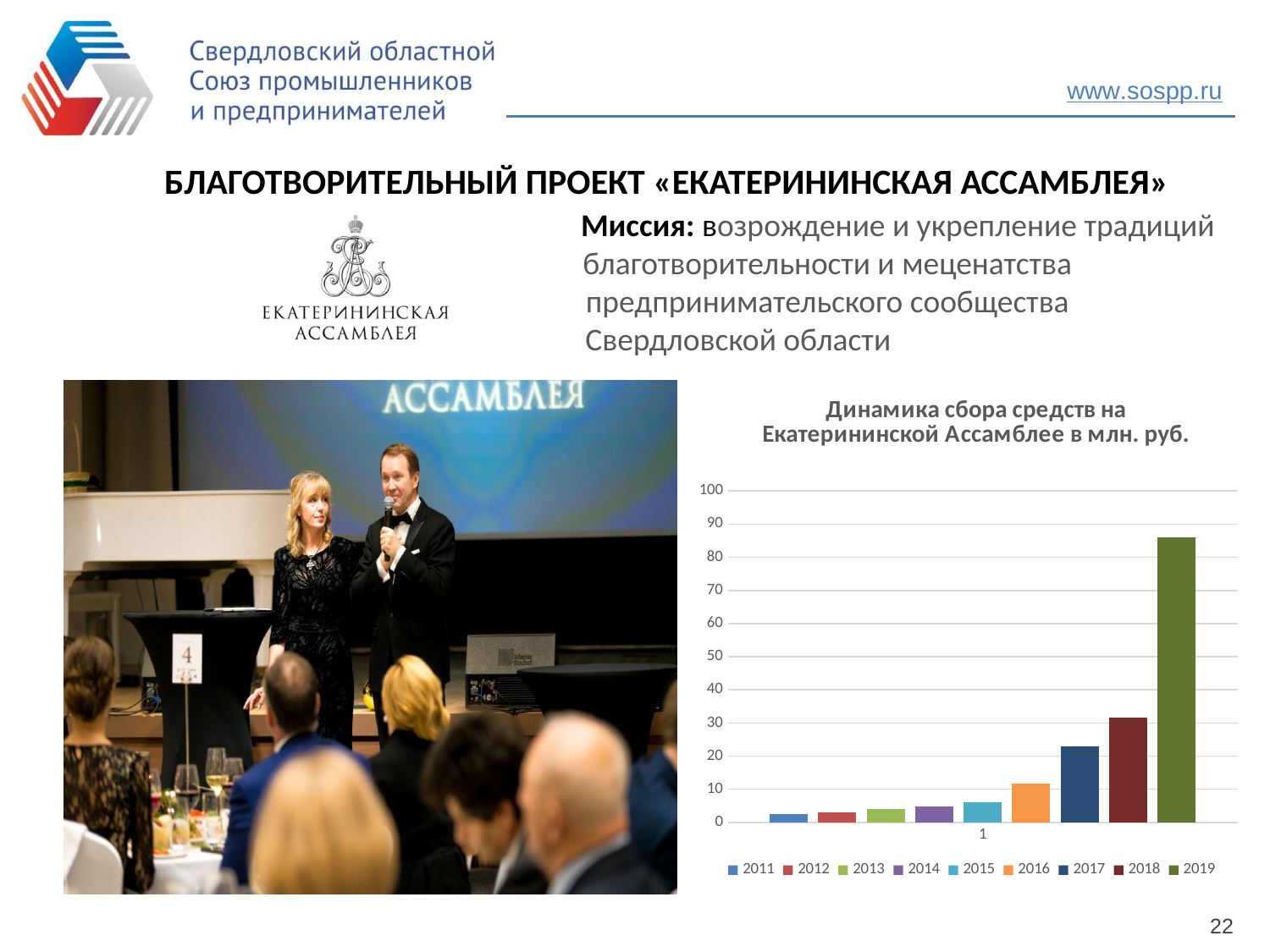
Is the value for 2015 greater or less than 10? less Is the value for 2016 greater or less than 20? less What kind of chart is shown on the slide? bar chart Which is larger, the value for 2016 or the value for 2013? 2016 Which is larger, the value for 2018 or the value for 2017? 2018 Do the values rise or fall from 2011 to 2019? rise Is the value for 2017 greater or less than 20? greater What is the title of the chart? Динамика сбора средств на Екатерининской Ассамблее в млн. руб. How many series does the legend of the chart list? 9 Which year has the highest value in the chart? 2019